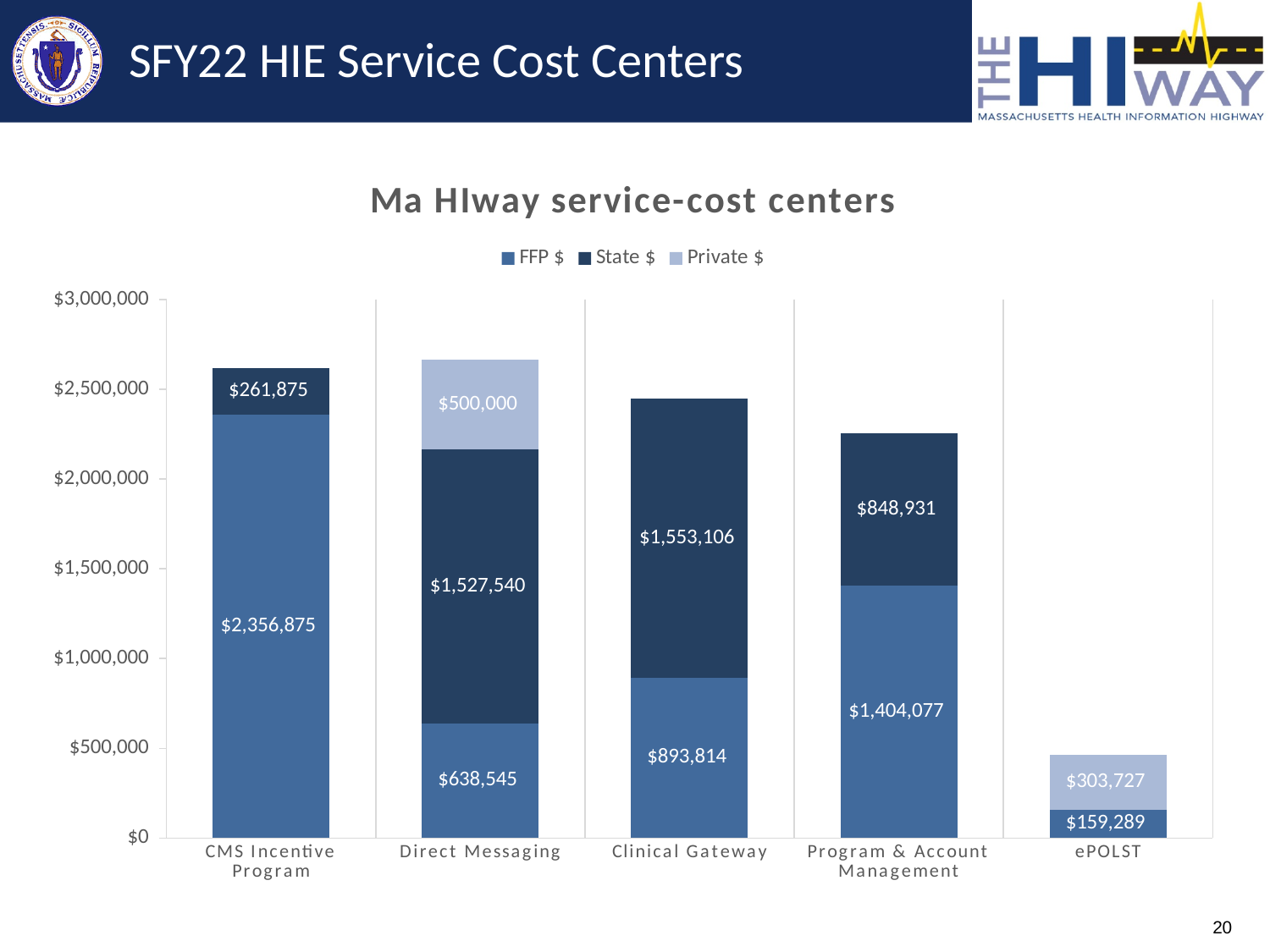
Is the total of the ePOLST bar greater or less than $500,000? less What kind of chart is shown on the slide? Stacked bar chart What is the FFP $ value for the CMS Incentive Program? $2,356,875 What is the total of the stacked bar for the CMS Incentive Program? $2,618,750 What is the State $ value for Clinical Gateway? $1,553,106 How many cost-center categories are shown on the x axis? 5 Which is larger, the State $ value for Direct Messaging or the State $ value for Clinical Gateway? Clinical Gateway What is the title of the chart? Ma HIway service-cost centers How many series does the legend list? 3 What is the difference between the FFP $ value for Program & Account Management and the FFP $ value for Clinical Gateway? $510,263 Which category has the largest FFP $ value? CMS Incentive Program What is the Private $ value for Direct Messaging? $500,000